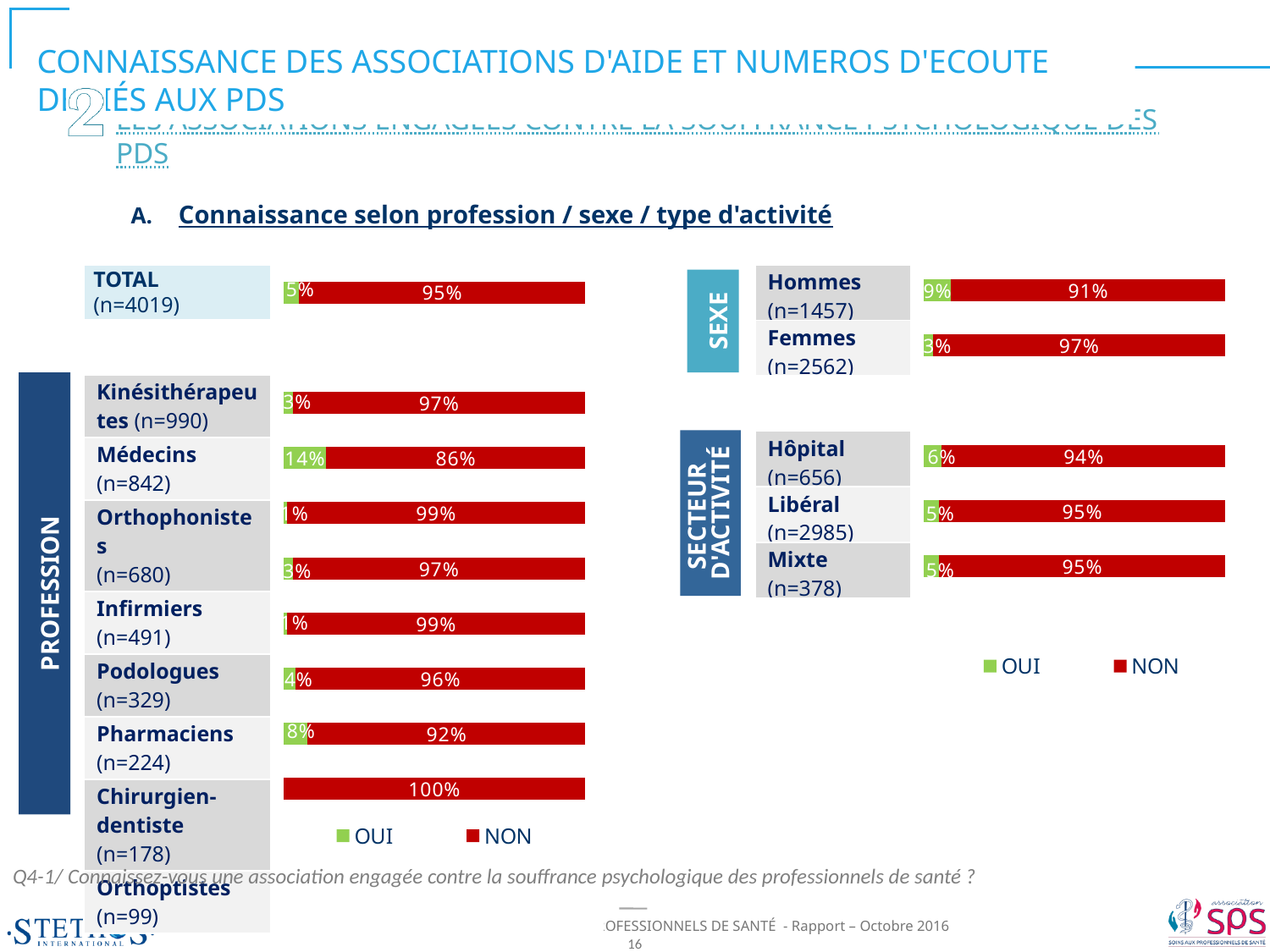
In the PROFESSION chart, what percentage of the TOTAL (n=4019) answered NON? 95% In the SEXE chart, what percentage of Femmes answered NON? 97% How many series does the legend of the PROFESSION chart list? 2 What type of chart is used for the SEXE data? Bar chart How many sectors are shown in the SECTEUR D'ACTIVITÉ chart? 3 In the SECTEUR D'ACTIVITÉ chart, what percentage of Libéral respondents answered NON? 95% In the SEXE chart, what percentage of Hommes answered OUI? 9% In the SECTEUR D'ACTIVITÉ chart, what percentage of Hôpital respondents answered OUI? 6% In the SEXE chart, which group has the higher OUI share, Hommes or Femmes? Hommes In the PROFESSION chart, what percentage of Médecins answered OUI? 14% In the SEXE chart, what is the difference between the NON share for Femmes and the NON share for Hommes? 6 percentage points In the SECTEUR D'ACTIVITÉ chart, which sector has the highest OUI share? Hôpital